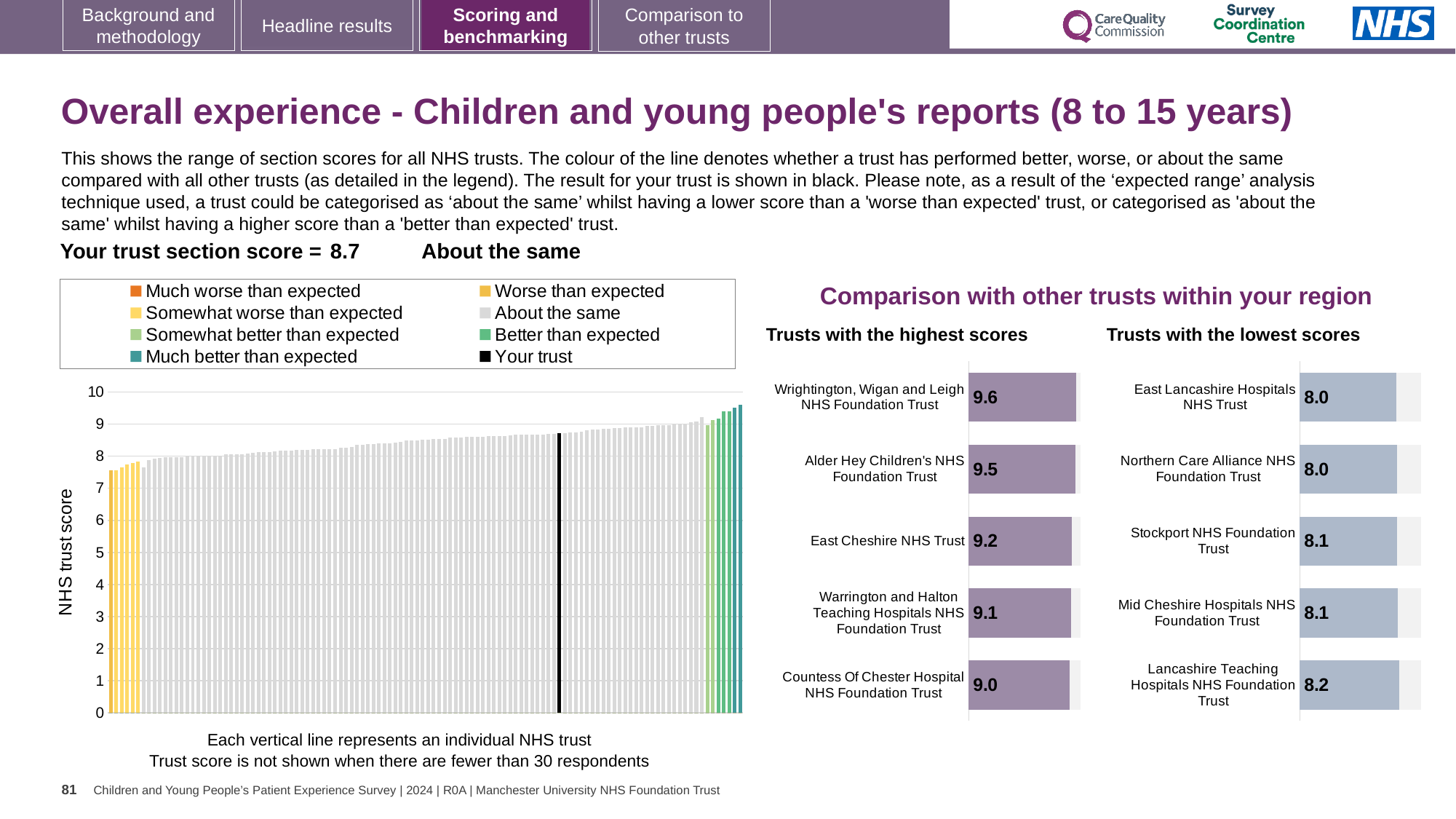
In the main chart showing all NHS trusts, what is the section score for your trust (the black bar)? 8.7 In the 'Trusts with the lowest scores' chart, what is the score for East Lancashire Hospitals NHS Trust? 8.0 In the 'Trusts with the lowest scores' chart, what is the score for Stockport NHS Foundation Trust? 8.1 In the 'Trusts with the highest scores' chart, what is the score for Alder Hey Children's NHS Foundation Trust? 9.5 In the main chart showing all NHS trusts, do the trust scores rise or fall from left to right? rise In the 'Trusts with the highest scores' chart, what is the difference between the scores of Wrightington, Wigan and Leigh NHS Foundation Trust and Countess Of Chester Hospital NHS Foundation Trust? 0.6 In the 'Trusts with the lowest scores' chart, which trust has the highest score? Lancashire Teaching Hospitals NHS Foundation Trust In the main chart showing all NHS trusts, is the value for your trust (the black bar) greater or less than 8? greater What kind of chart is the main chart showing all NHS trusts? bar chart In the 'Trusts with the lowest scores' chart, which has the larger score: Stockport NHS Foundation Trust or Lancashire Teaching Hospitals NHS Foundation Trust? Lancashire Teaching Hospitals NHS Foundation Trust How many trusts are shown in the 'Trusts with the highest scores' chart? 5 In the 'Trusts with the highest scores' chart, which trust has the highest score? Wrightington, Wigan and Leigh NHS Foundation Trust